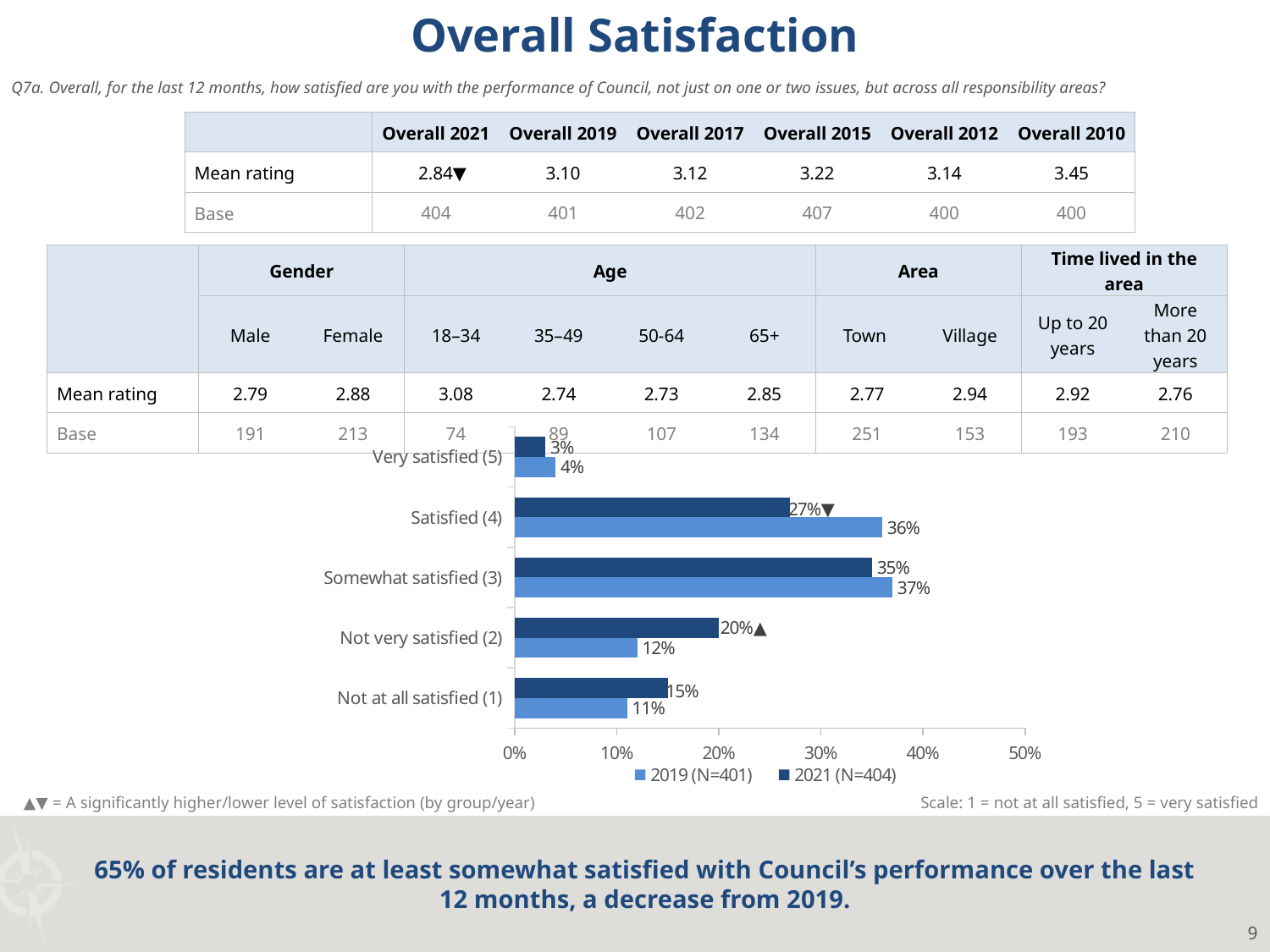
What is the 2021 value for Not very satisfied (2)? 20% What is the 2019 value for Not at all satisfied (1)? 11% What sample size does the legend give for the 2021 series? N=404 Which category has the lowest 2019 value? Very satisfied (5) What is the 2021 value for Satisfied (4)? 27% What kind of chart is shown on the slide? bar chart Which category has the highest 2021 value? Somewhat satisfied (3) What is the 2019 value for Somewhat satisfied (3)? 37% How many satisfaction categories are plotted in the chart? 5 How many series does the chart legend list? 2 What is the difference between the 2019 and 2021 values for Satisfied (4)? 9% For Not at all satisfied (1), which year has the larger value, 2019 or 2021? 2021